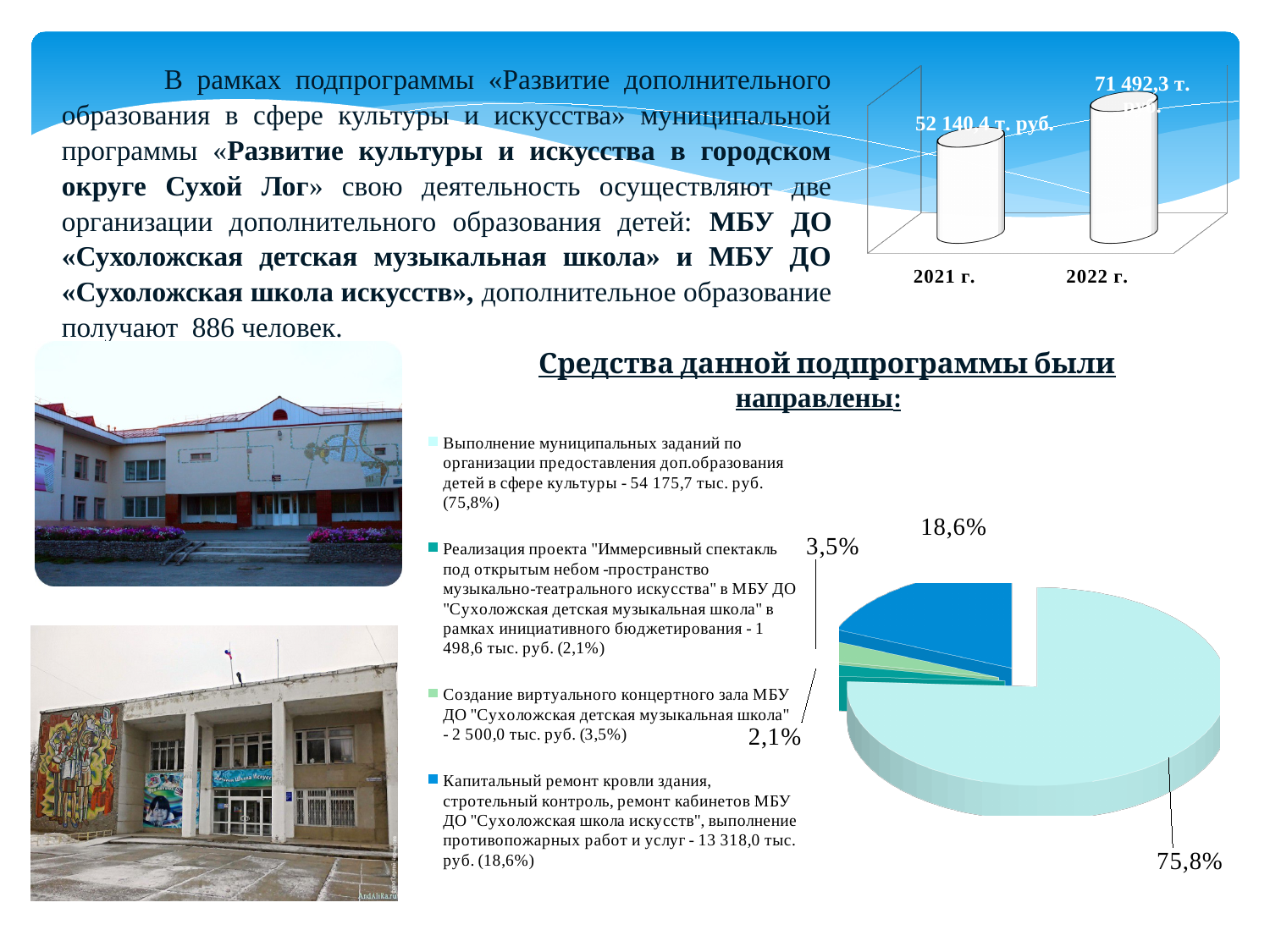
What kind of chart is the chart at the bottom right of the slide? pie chart In the bar chart at the top right, do the values rise or fall from 2021 г. to 2022 г.? rise What kind of chart is the chart at the top right of the slide? bar chart In the pie chart at the bottom right, what share corresponds to the creation of the virtual concert hall (Создание виртуального концертного зала)? 3,5% According to the legend of the pie chart at the bottom right, what amount was spent on the capital roof repair and related works at МБУ ДО «Сухоложская школа искусств»? 13 318,0 тыс. руб. In the pie chart at the bottom right, how many slices are there? 4 In the pie chart at the bottom right, what is the share of the smallest slice? 2,1% In the bar chart at the top right, what is the value for 2021 г.? 52 140,4 т. руб. In the bar chart at the top right, how many categories are shown? 2 In the pie chart at the bottom right, what share does the largest slice have? 75,8% In the bar chart at the top right, which year has the higher value, 2021 г. or 2022 г.? 2022 г. In the bar chart at the top right, what is the difference between the 2022 г. and 2021 г. values? 19 351,9 т. руб.